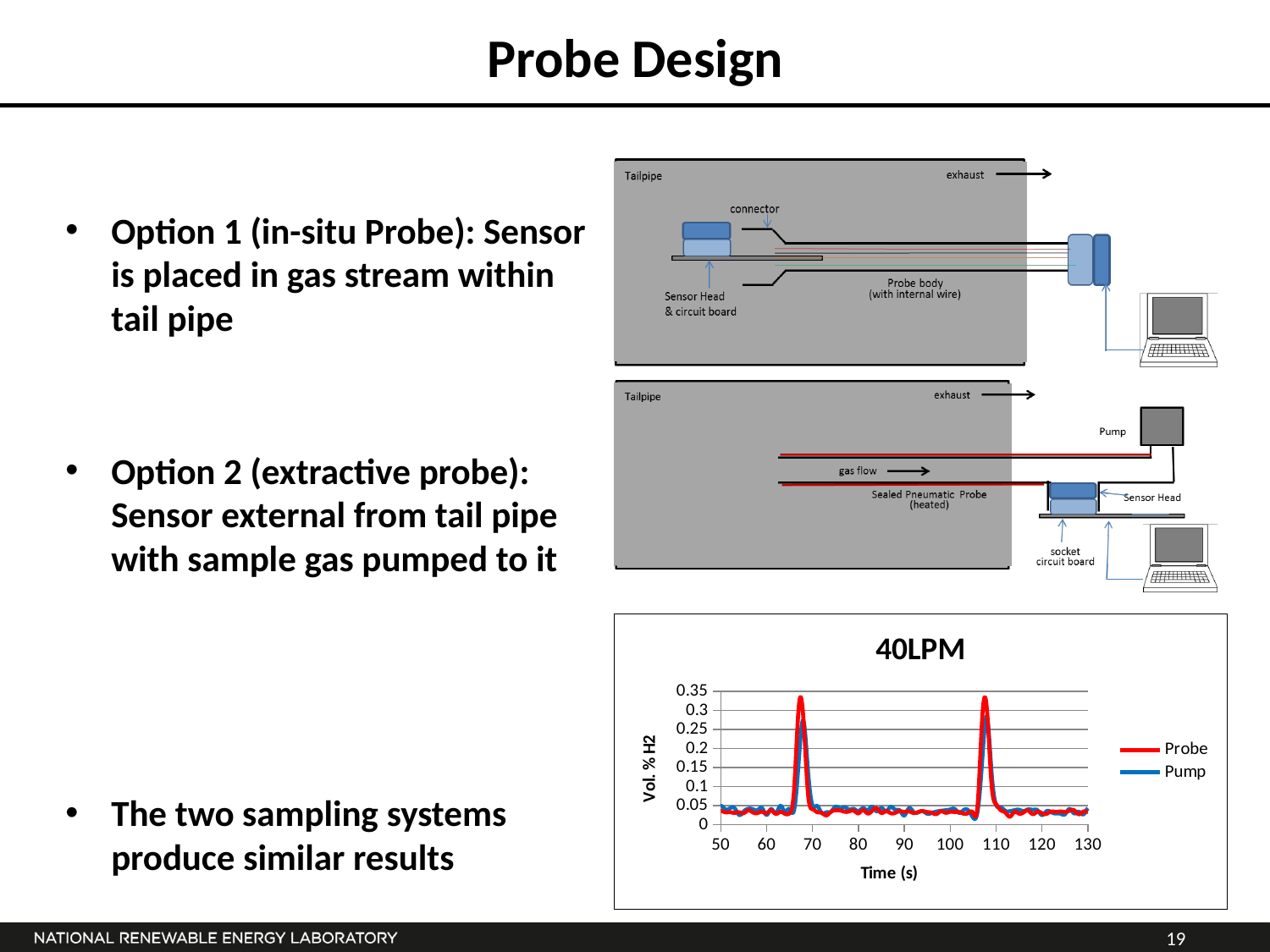
What is the label of the chart's y axis? Vol. % H2 How many peaks do the series show over the plotted time range? 2 Is the peak value of the Pump series greater or less than 0.2? greater Is the baseline value of the Probe series between the peaks greater or less than 0.1? less How many series does the chart's legend list? 2 What are the two series named in the chart's legend? Probe and Pump Is the peak value of the Probe series greater or less than 0.25? greater What is the highest value shown on the chart's y axis? 0.35 At the peaks, which series reaches a higher value, Probe or Pump? Probe What kind of chart is shown on the slide? line chart